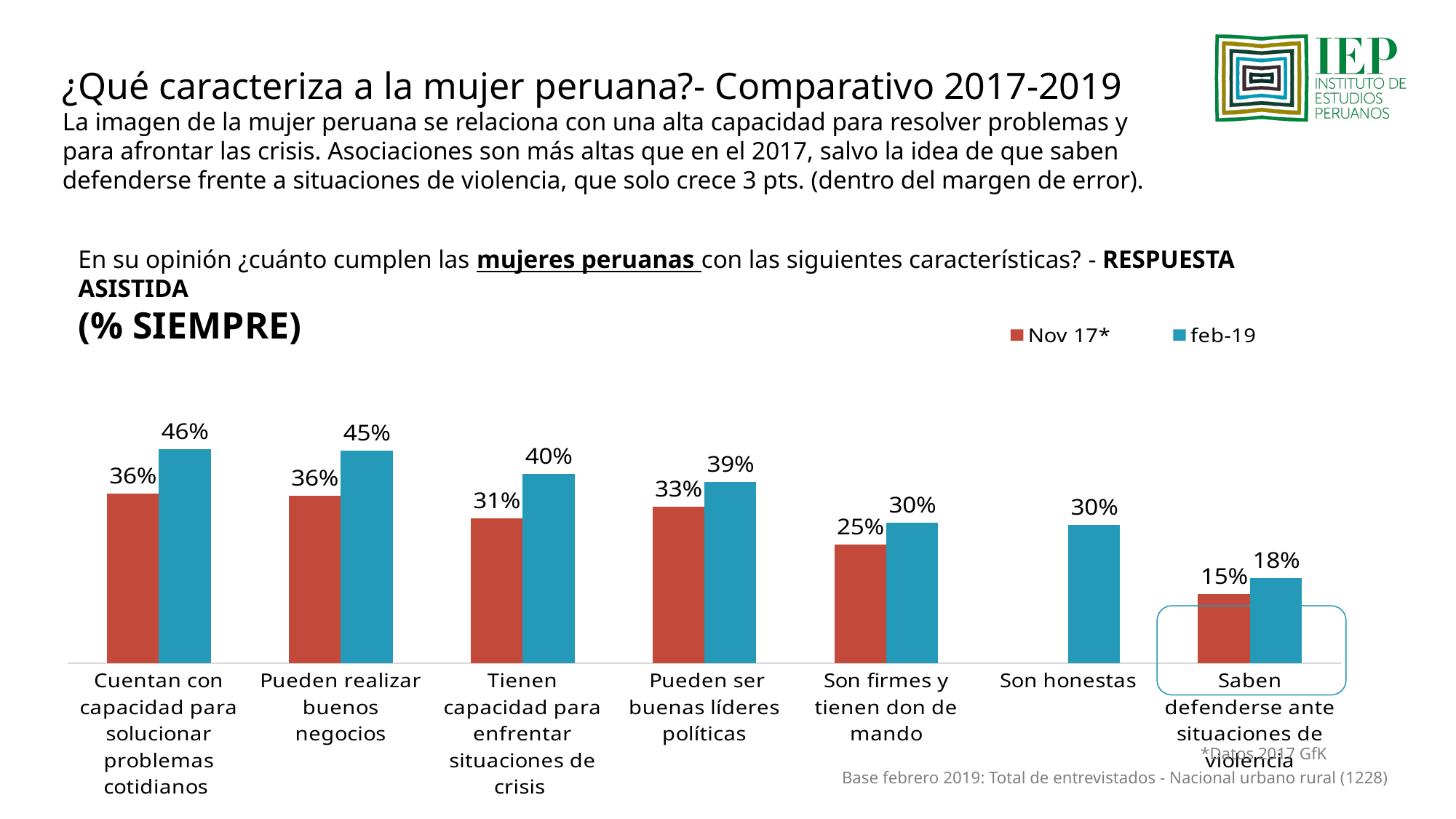
What is the Nov 17* value for "Tienen capacidad para enfrentar situaciones de crisis"? 31% What is the difference between the feb-19 and Nov 17* values for "Pueden realizar buenos negocios"? 9 percentage points What is the feb-19 value for "Son honestas"? 30% What colour are the feb-19 bars? Blue Which category has the lowest Nov 17* value? Saben defenderse ante situaciones de violencia Which is larger for "Son firmes y tienen don de mando": the Nov 17* value or the feb-19 value? feb-19 How many series does the legend list? 2 What is the feb-19 value for "Cuentan con capacidad para solucionar problemas cotidianos"? 46% Which category has no Nov 17* bar? Son honestas Which category has the highest feb-19 value? Cuentan con capacidad para solucionar problemas cotidianos How many categories are shown on the x axis? 7 What kind of chart is shown on the slide? Bar chart